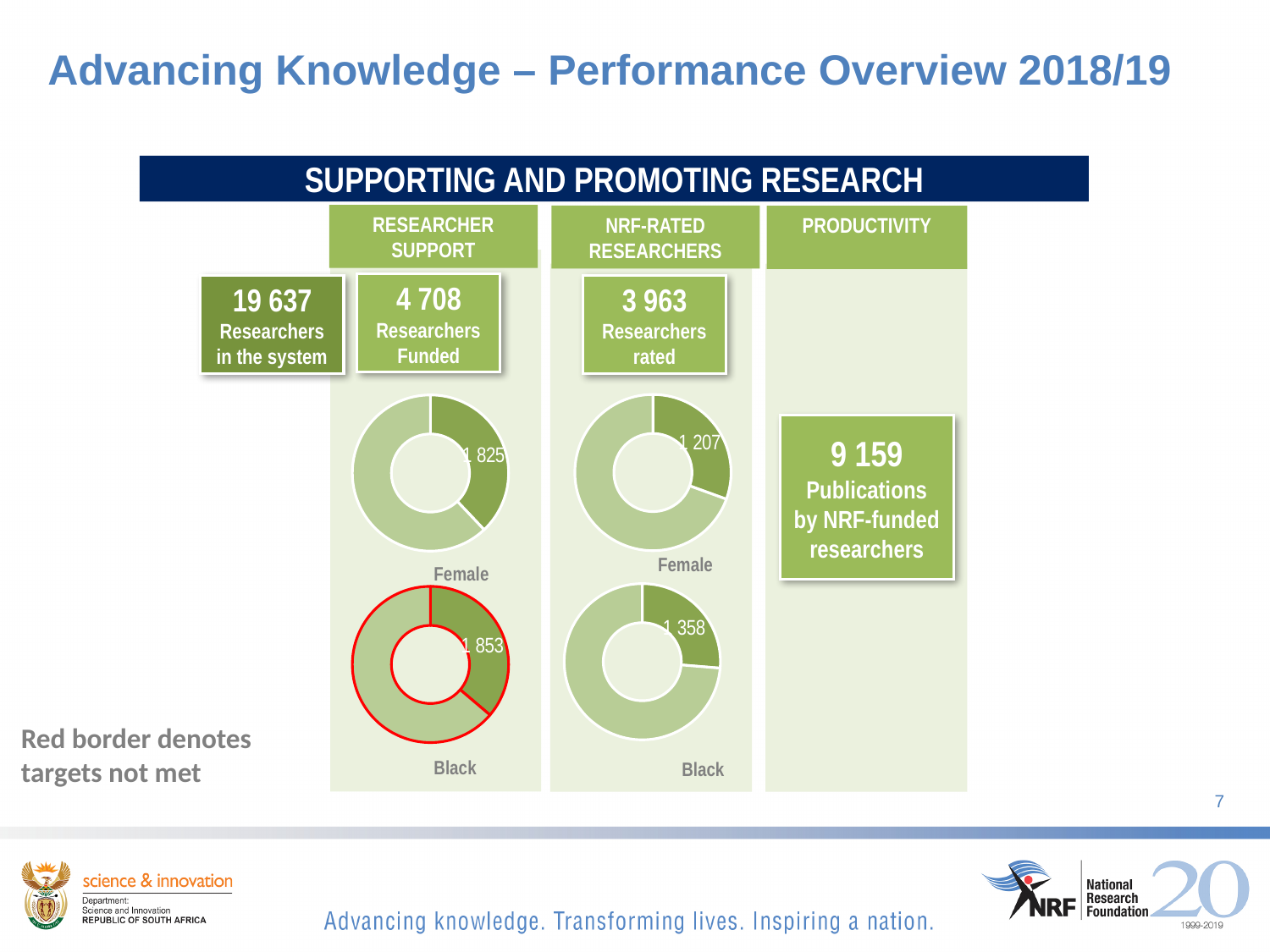
In the Female donut chart under NRF-Rated Researchers, what value is labelled on the highlighted slice? 1 207 What is the difference between the Black value (1 853) and the Female value (1 825) under Researcher Support? 28 What is the difference between the Female value under Researcher Support (1 825) and the Female value under NRF-Rated Researchers (1 207)? 618 What is the difference between the Black value (1 358) and the Female value (1 207) under NRF-Rated Researchers? 151 How many donut charts are shown on the slide? 4 Which donut chart on the slide has a red border, indicating a target not met? Black under Researcher Support Which is larger: the Black value under Researcher Support or the Black value under NRF-Rated Researchers? Black under Researcher Support In the Female donut chart under Researcher Support, what value is labelled on the highlighted slice? 1 825 What kind of chart is used to show the Female and Black figures on this slide? Donut chart In the Black donut chart under NRF-Rated Researchers, what value is labelled on the highlighted slice? 1 358 Which is larger: the Female value under NRF-Rated Researchers or the Black value under NRF-Rated Researchers? Black In the Black donut chart under Researcher Support, what value is labelled on the highlighted slice? 1 853